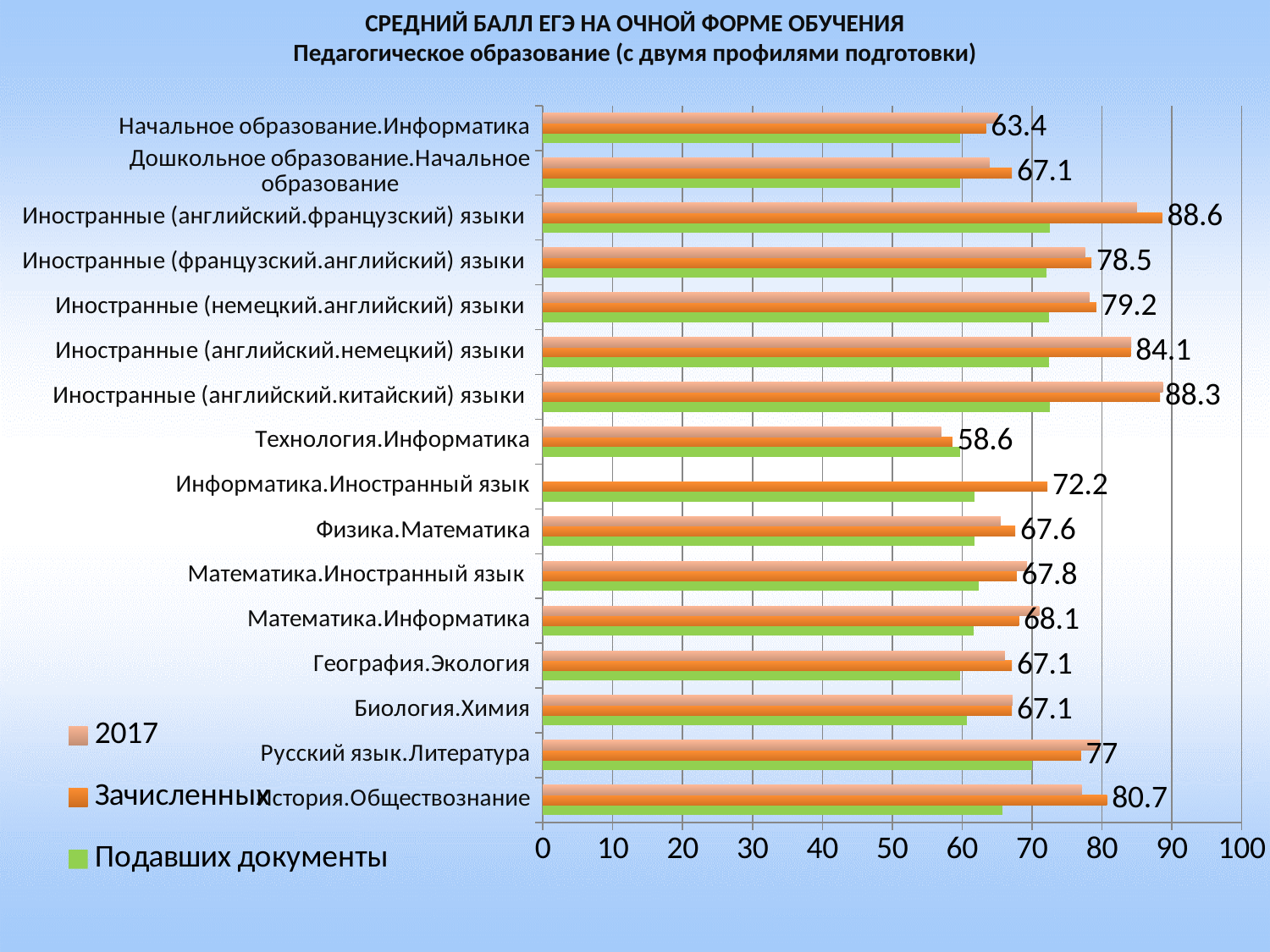
Which is larger, the Зачисленных value for Иностранные (английский.немецкий) языки or for Иностранные (немецкий.английский) языки? Иностранные (английский.немецкий) языки What is the Зачисленных value for Русский язык.Литература? 77 What is the Зачисленных value for Технология.Информатика? 58.6 What is the Зачисленных value for Иностранные (английский.французский) языки? 88.6 How many categories are shown on the chart? 16 How many series does the legend list? 3 What kind of chart is shown on the slide? bar chart Is the Подавших документы value for История.Обществознание greater or less than 60? greater Which category has the lowest Зачисленных value? Технология.Информатика What is the difference between the Зачисленных values for Иностранные (английский.французский) языки and Технология.Информатика? 30 Which category has the highest Зачисленных value? Иностранные (английский.французский) языки What is the Зачисленных value for История.Обществознание? 80.7